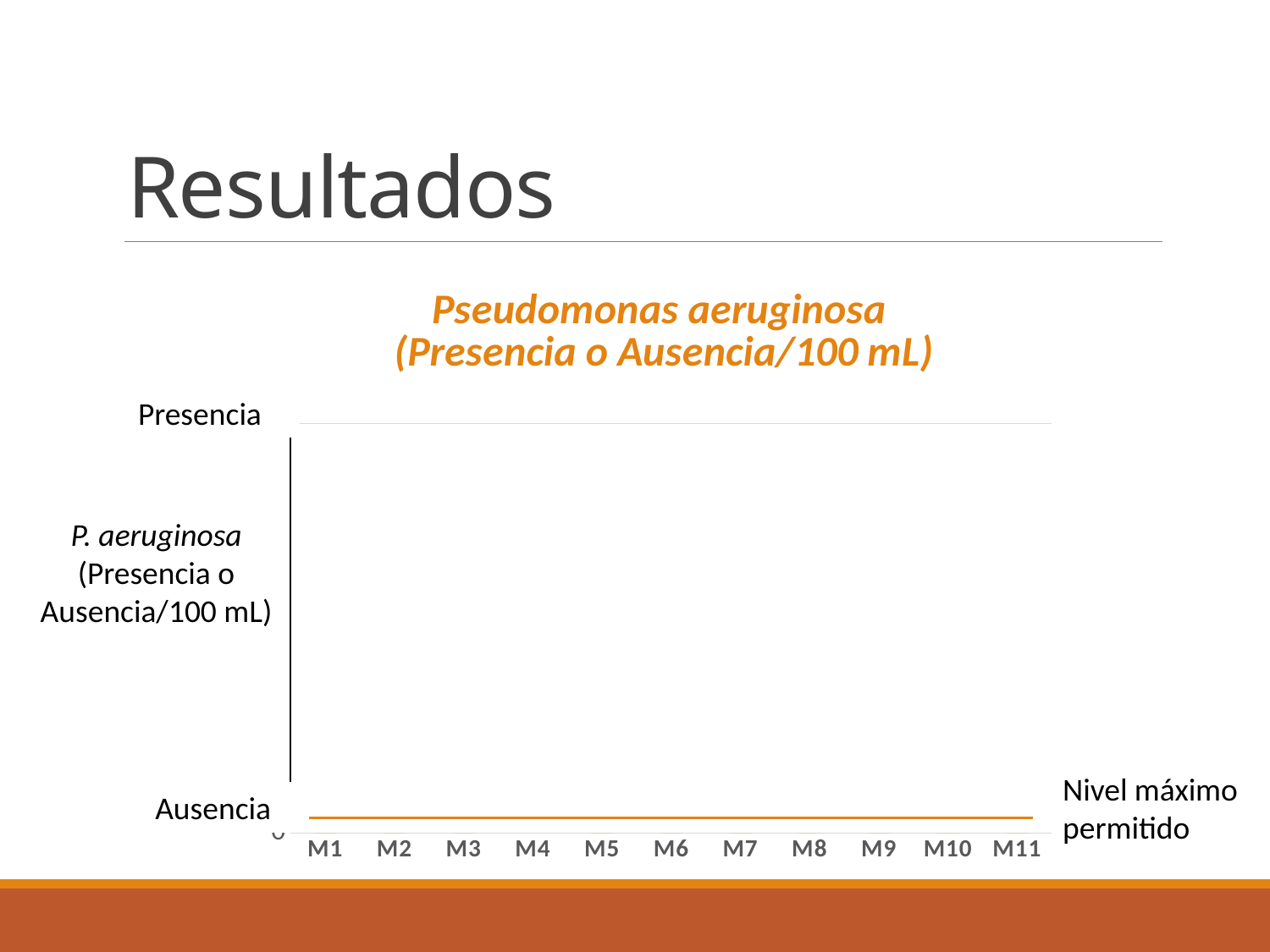
What label is shown at the bottom of the y axis? Ausencia What is the label of the last category on the x axis? M11 How many categories are shown on the x axis of the chart? 11 What does the orange horizontal line in the chart represent? Nivel máximo permitido What is the label of the first category on the x axis? M1 At which y-axis level does the 'Nivel máximo permitido' line sit? Ausencia What is the y-axis title of the chart? P. aeruginosa (Presencia o Ausencia/100 mL) Does the 'Nivel máximo permitido' line rise, fall or stay flat from M1 to M11? stay flat What is the title of the chart? Pseudomonas aeruginosa (Presencia o Ausencia/100 mL) What label is shown at the top of the y axis? Presencia